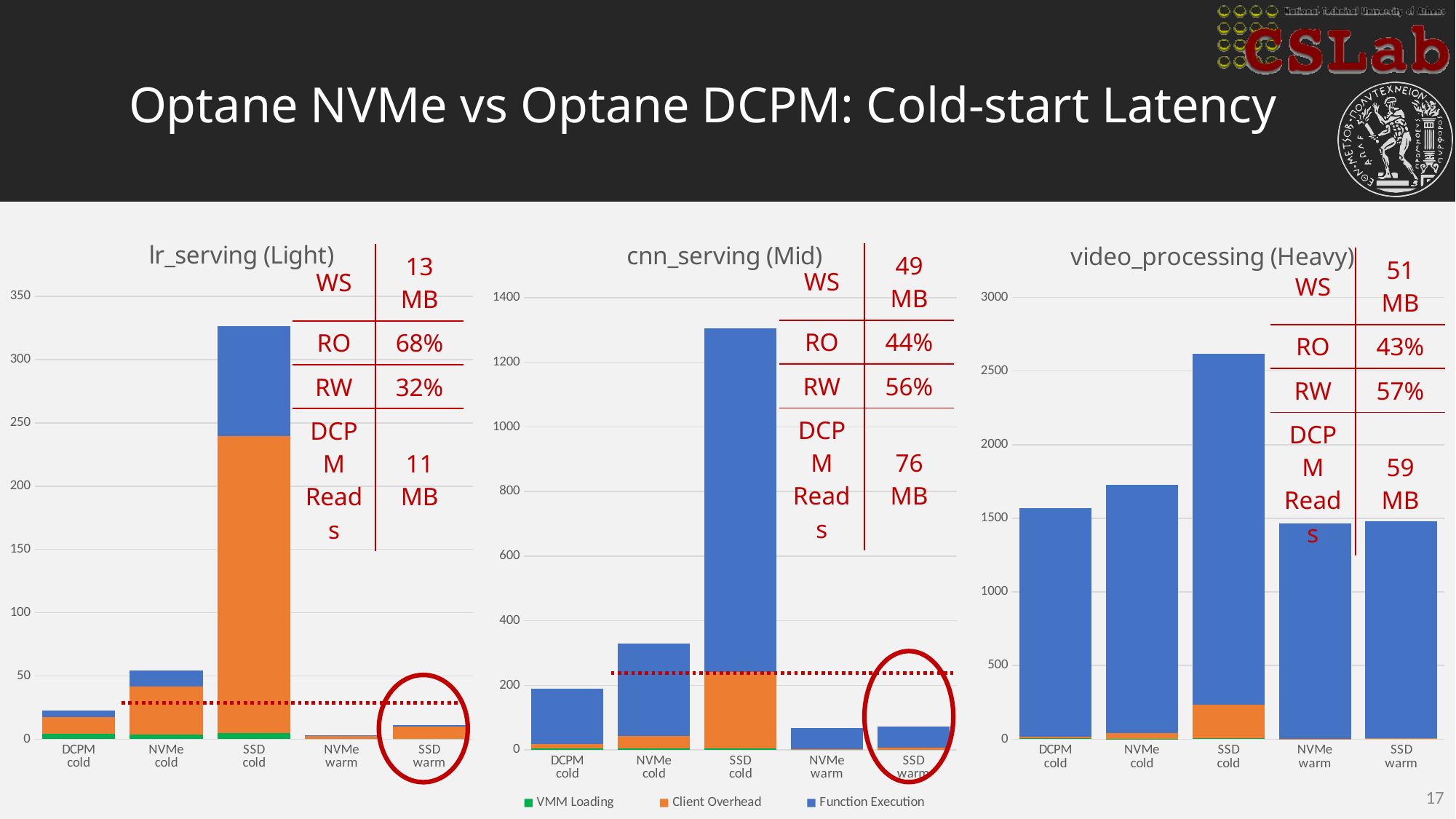
In the video_processing (Heavy) chart, which category has the tallest bar? SSD cold In the cnn_serving (Mid) chart, is the total bar for NVMe cold greater or less than 400? less In the video_processing (Heavy) chart, which bar is taller, NVMe cold or DCPM cold? NVMe cold In the cnn_serving (Mid) chart, is the total bar for SSD cold greater or less than 1200? greater In the video_processing (Heavy) chart, is the total bar for SSD cold greater or less than 2500? greater What kind of chart is the lr_serving (Light) chart? Stacked bar chart How many categories are shown on the x axis of the cnn_serving (Mid) chart? 5 How many series does the legend at the bottom of the slide list? 3 In the cnn_serving (Mid) chart, which category has the tallest bar? SSD cold In the lr_serving (Light) chart, which category has the tallest bar? SSD cold